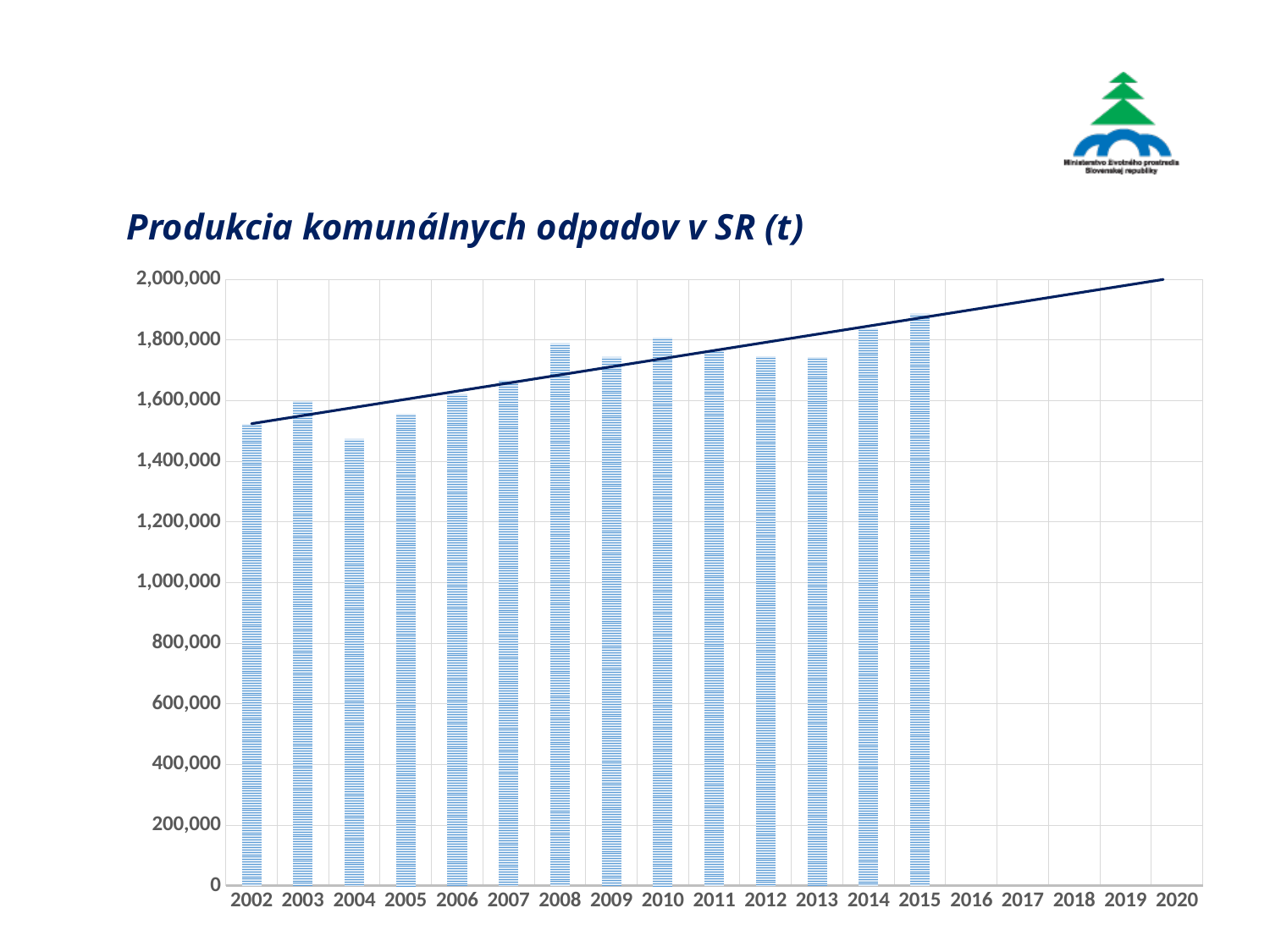
Is the value for 2012 greater or less than 1,600,000? greater Which year has the highest bar? 2015 Is the value for 2004 greater or less than 1,600,000? less What kind of chart is shown on the slide? bar chart Which year has the lowest bar? 2004 Do the bar values generally rise or fall from 2002 to 2015? rise Is the value for 2002 greater or less than 1,600,000? less Which is larger, the value for 2003 or the value for 2004? 2003 What is the title of the chart? Produkcia komunálnych odpadov v SR (t) How many years have a bar plotted in the chart? 14 Which is larger, the value for 2002 or the value for 2015? 2015